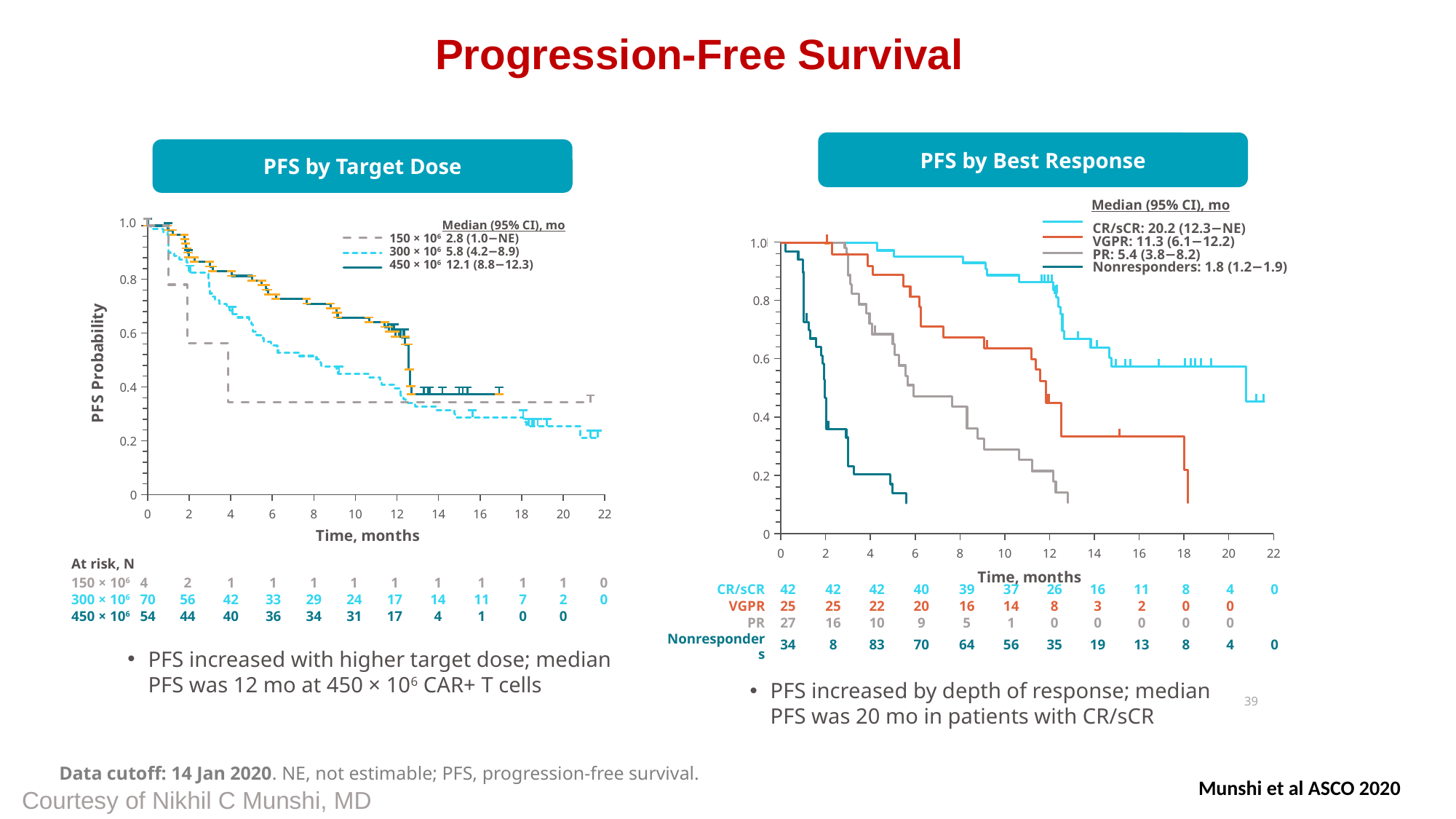
In the 'PFS by Best Response' chart, is the PFS probability for the CR/sCR group at 16 months greater or less than 0.4? greater In the 'PFS by Target Dose' chart, how many patients in the 300 × 10⁶ group were at risk at 0 months? 70 In the 'PFS by Target Dose' chart, what is the median PFS in months for the 150 × 10⁶ dose group? 2.8 In the 'PFS by Best Response' chart, what is the median PFS in months for the VGPR group? 11.3 In the 'PFS by Target Dose' chart, what is the difference in median PFS (months) between the 450 × 10⁶ and 150 × 10⁶ groups? 9.3 In the 'PFS by Best Response' chart, which response group has the highest median PFS? CR/sCR In the 'PFS by Target Dose' chart, how many dose groups does the legend list? 3 In the 'PFS by Target Dose' chart, what is the median PFS in months for the 450 × 10⁶ dose group? 12.1 In the 'PFS by Target Dose' chart, is the PFS probability for the 300 × 10⁶ group at 20 months greater or less than 0.4? less What kind of chart is the 'PFS by Best Response' chart? Line chart (Kaplan-Meier survival curve) In the 'PFS by Best Response' chart, how many PR patients were at risk at 0 months? 27 In the 'PFS by Best Response' chart, which response group has the lowest median PFS? Nonresponders